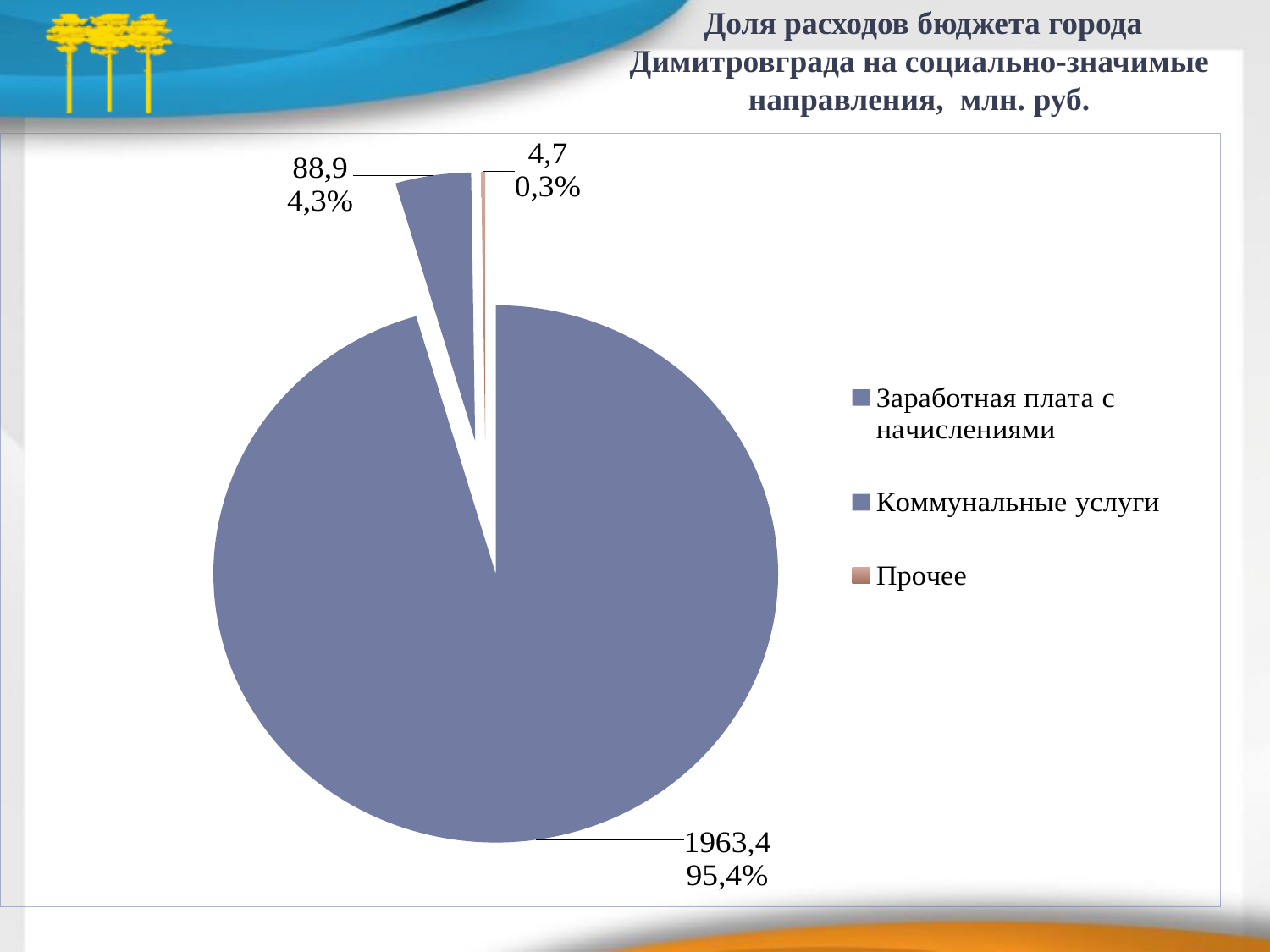
What share of the pie does Коммунальные услуги take? 4,3% Which category has the largest slice? Заработная плата с начислениями What is the difference between the values for Коммунальные услуги and Прочее? 84,2 How many entries does the legend list? 3 What is the value for Прочее? 4,7 What is the value for Заработная плата с начислениями? 1963,4 What share of the pie does Прочее take? 0,3% What is the value for Коммунальные услуги? 88,9 Which is larger, the value for Коммунальные услуги or the value for Прочее? Коммунальные услуги What kind of chart is shown on the slide? pie chart What share of the pie does Заработная плата с начислениями take? 95,4% Which category has the smallest slice? Прочее